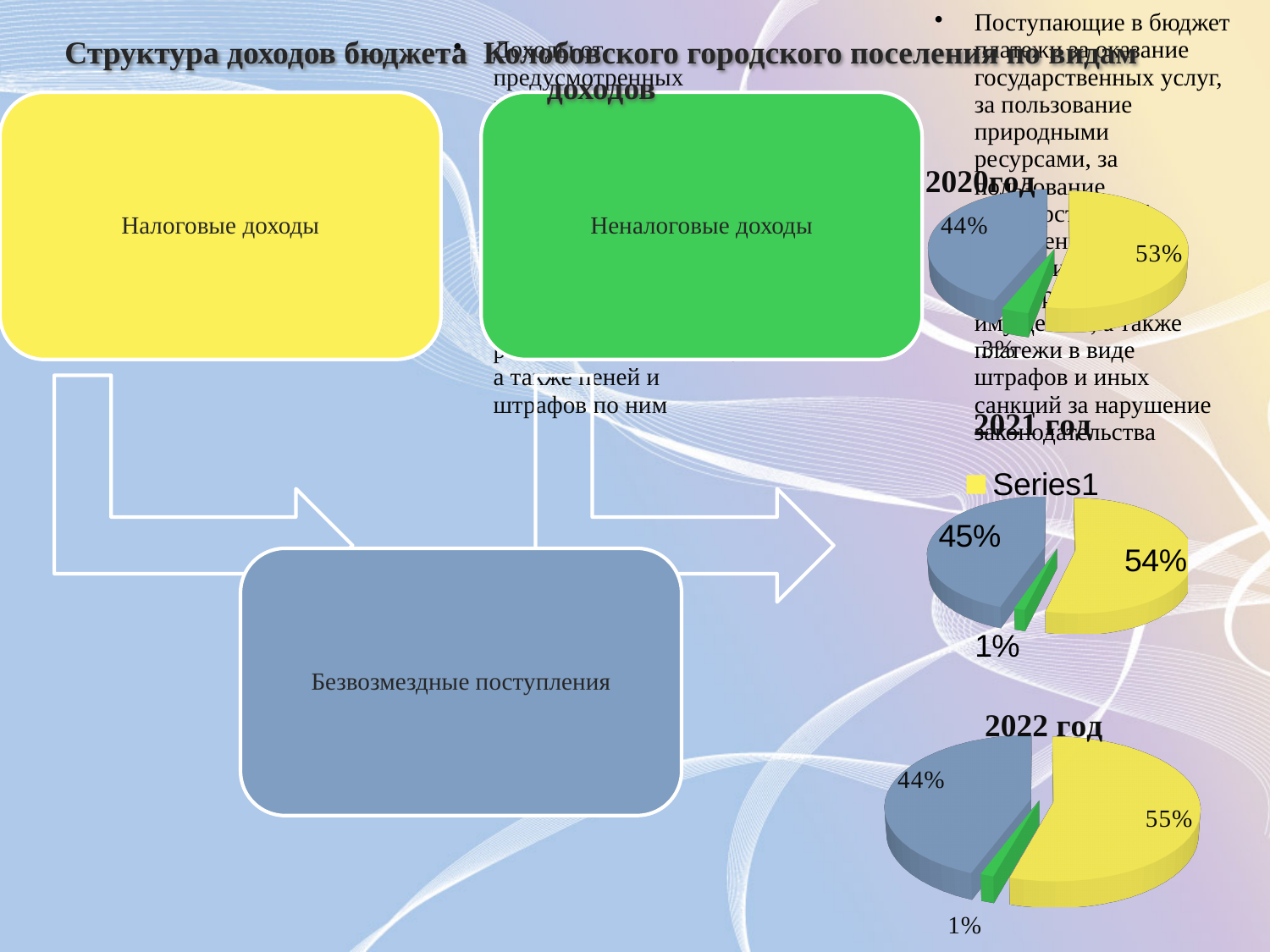
In the 2021 год chart, what percentage is shown for the green slice? 1% In the 2022 год chart, which slice is the smallest? The green slice (1%) In the 2021 год chart, what percentage is shown for the blue slice? 45% What legend entry is shown above the 2021 год chart? Series1 What type of charts are shown on the right side of the slide? Pie charts In the 2020 год chart, what percentage is shown for the blue slice? 44% How many slices does the 2022 год pie chart have? 3 In the 2022 год chart, what is the difference between the yellow slice and the blue slice? 11 percentage points In the 2022 год chart, what percentage is shown for the yellow slice? 55% In the 2020 год chart, what percentage is shown for the yellow slice? 53% In the 2022 год chart, what percentage is shown for the blue slice? 44% In the 2021 год chart, what percentage is shown for the yellow slice? 54%